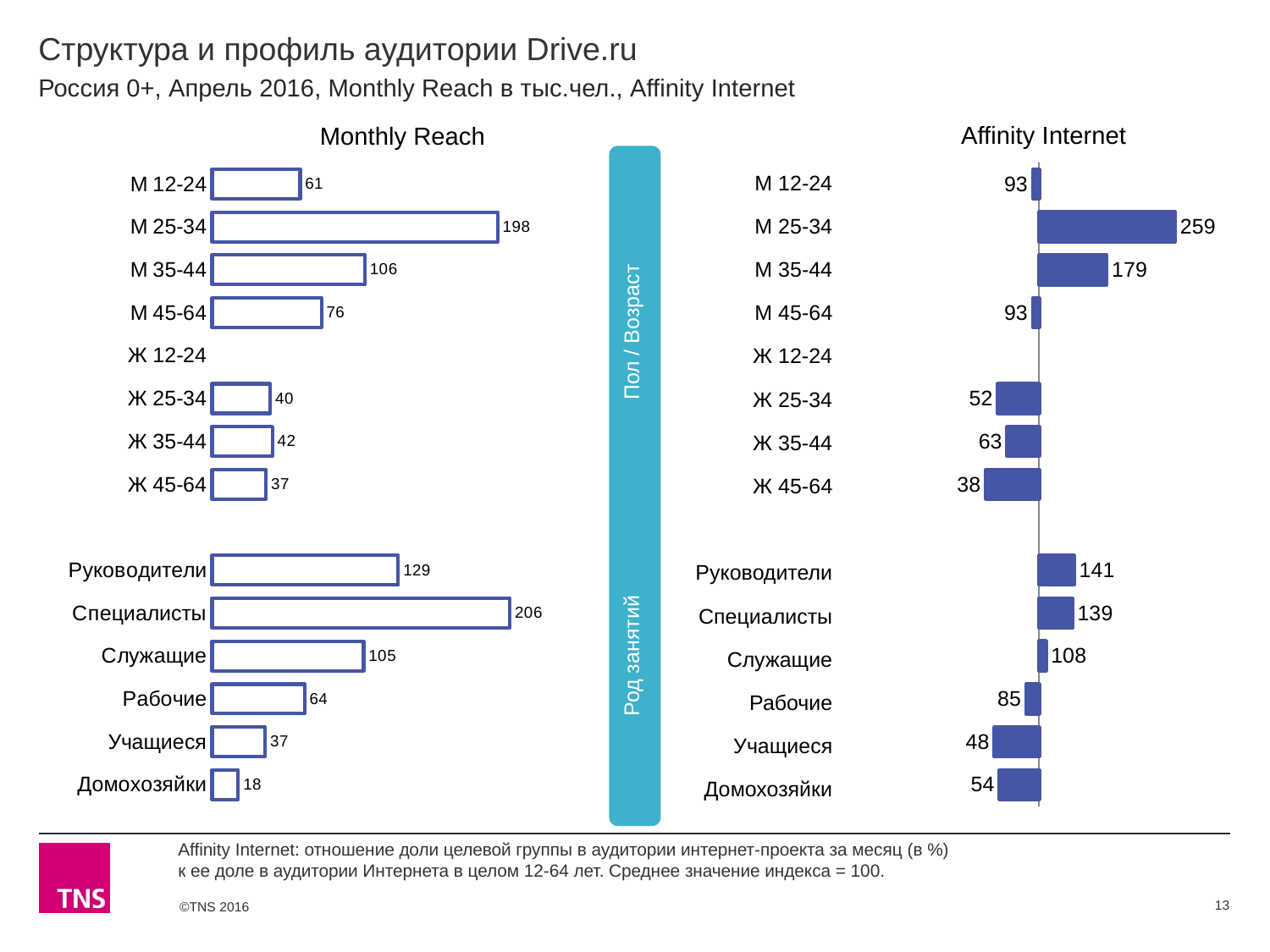
In the Affinity Internet chart, what is the value for Учащиеся? 48 In the Affinity Internet chart, what is the value for Рабочие? 85 What type of chart is the Affinity Internet chart? Bar chart In the Monthly Reach chart, which category has the highest value? Специалисты In the Affinity Internet chart, which category has the highest value? М 25-34 In the Monthly Reach chart, what is the value for Домохозяйки? 18 In the Affinity Internet chart, what is the value for М 35-44? 179 In the Monthly Reach chart, what is the value for М 25-34? 198 In the Monthly Reach chart, what is the difference between Специалисты and Руководители? 77 In the Monthly Reach chart, what is the difference between М 35-44 and М 45-64? 30 In the Affinity Internet chart, which is larger: Руководители or Служащие? Руководители In the Affinity Internet chart, which category has the lowest value? Ж 45-64